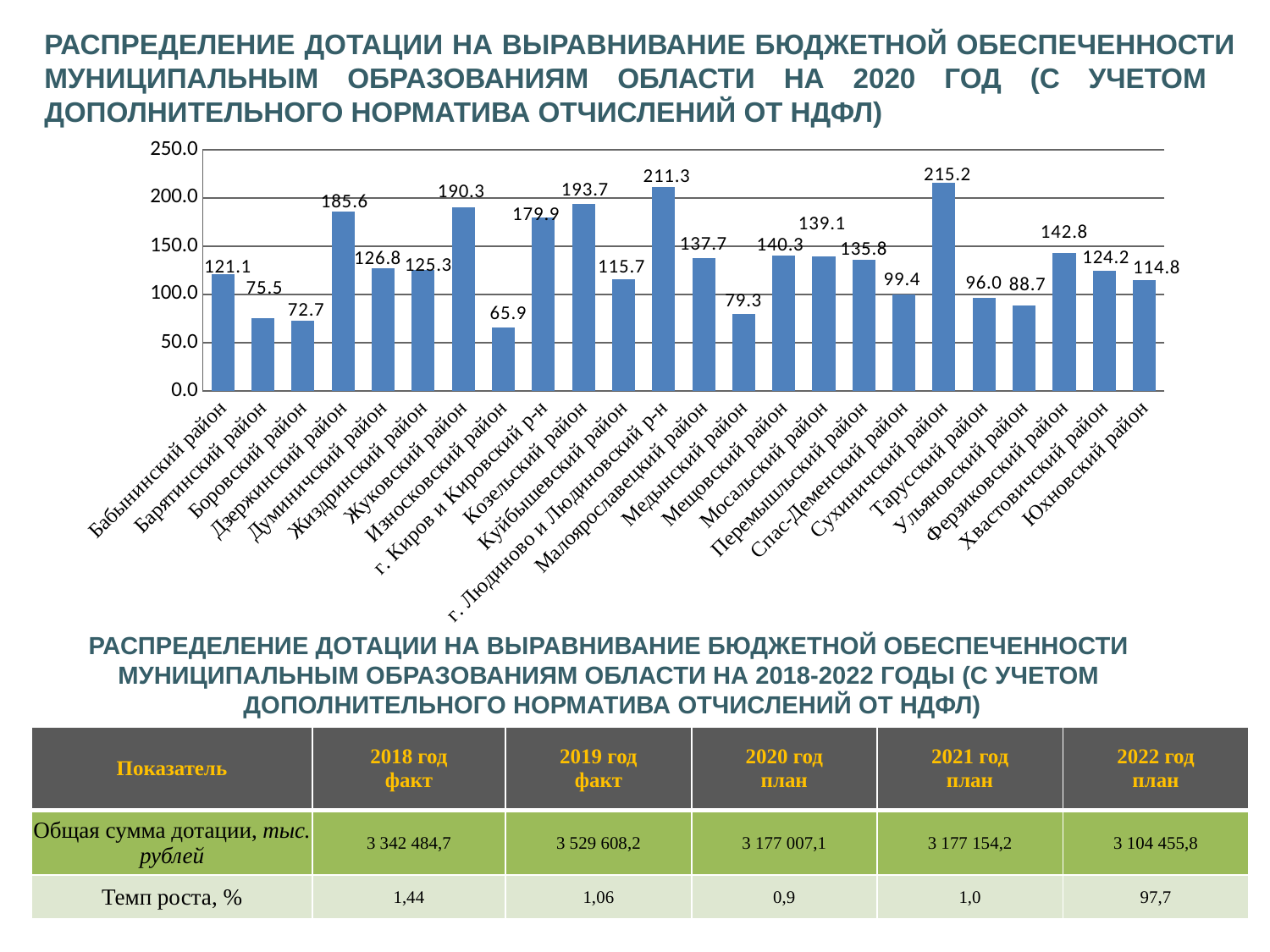
What is the value for Бабынинский район? 121.1 Which category has the lowest value? Износковский район Which category has the highest value? Сухиничский район What is the maximum value shown on the y axis of the chart? 250.0 How many categories are shown on the x axis of the chart? 24 What is the value for Ферзиковский район? 142.8 What is the value for Козельский район? 193.7 What type of chart is shown on the slide? bar chart Is the value for Тарусский район greater or less than 100.0? less What is the difference between the values for Дзержинский район and Жуковский район? 4.7 What is the difference between the values for Сухиничский район and Износковский район? 149.3 Which is larger, the value for Мещовский район or the value for Спас-Деменский район? Мещовский район